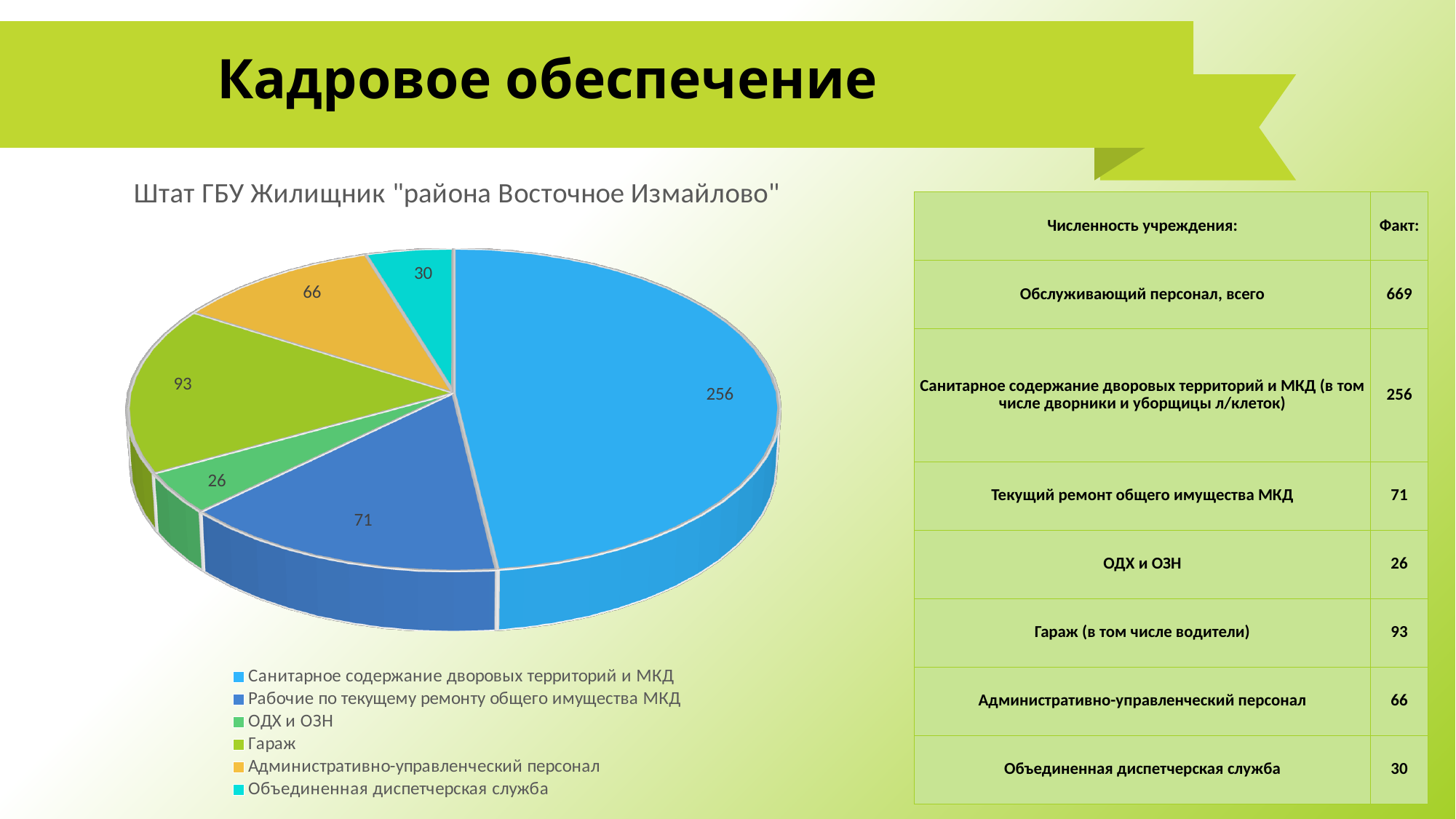
How many entries does the pie chart legend list? 6 What is the value of the slice for Объединенная диспетчерская служба? 30 Which category has the largest slice in the pie chart? Санитарное содержание дворовых территорий и МКД What is the difference between the values for Гараж and Административно-управленческий персонал? 27 What kind of chart is shown on the slide? Pie chart What colour is the slice for Административно-управленческий персонал? Yellow Which is larger: the slice for Рабочие по текущему ремонту общего имущества МКД or the slice for Административно-управленческий персонал? Рабочие по текущему ремонту общего имущества МКД What is the title of the pie chart? Штат ГБУ Жилищник "района Восточное Измайлово" What is the value of the slice for Гараж? 93 What is the value of the slice for Санитарное содержание дворовых территорий и МКД? 256 How many slices does the pie chart have? 6 Which category has the smallest slice in the pie chart? ОДХ и ОЗН